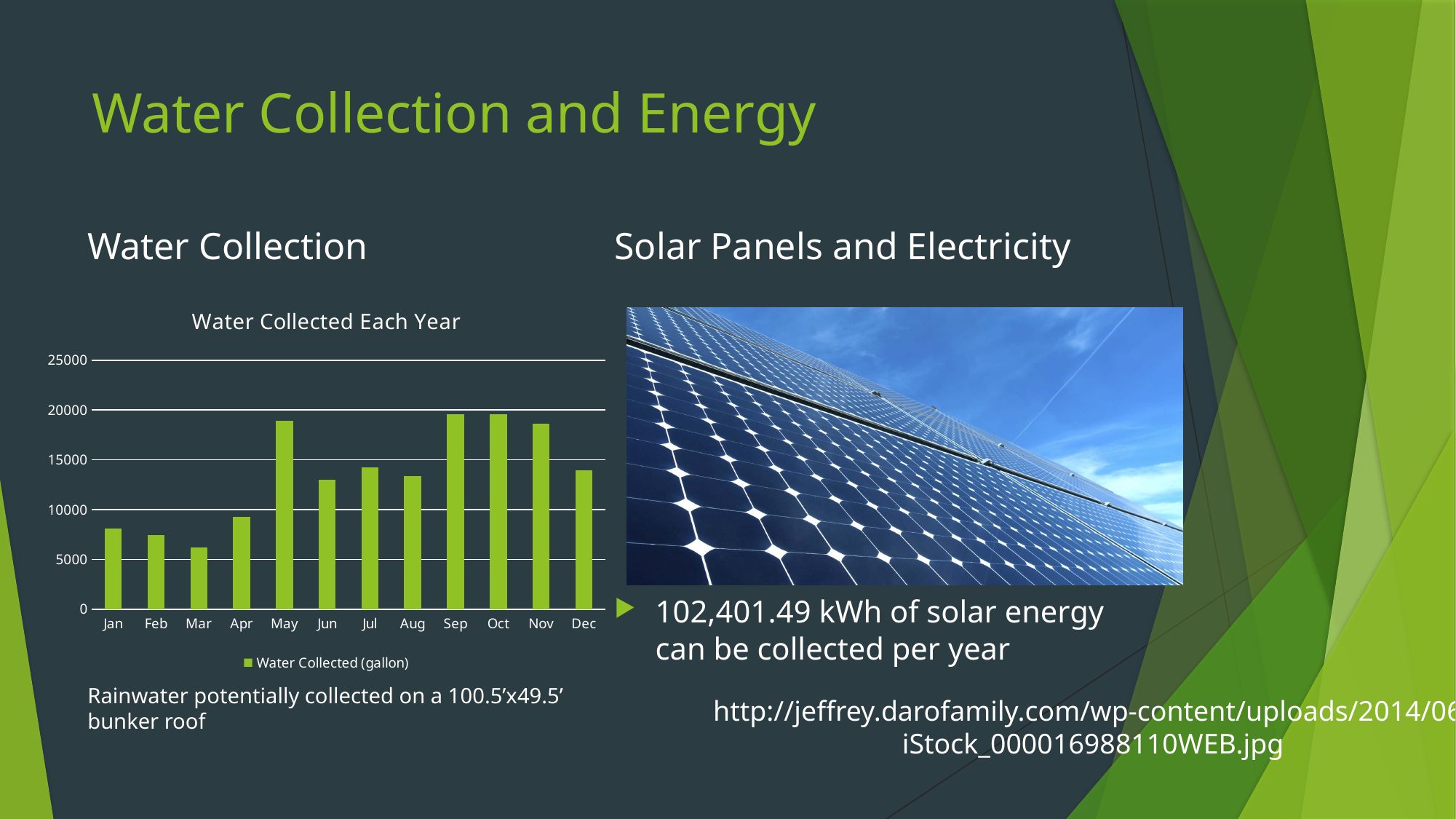
Which month has the lowest water collected in the chart? Mar Is the value for May greater or less than 15000? greater Which has a larger value, May or Jan? May How many series does the chart's legend list? 1 What kind of chart is shown on the slide? bar chart What is the title of the chart on the slide? Water Collected Each Year How many months are shown on the x axis of the chart? 12 Which has a larger value, Feb or Nov? Nov Is the value for Jan greater or less than 10000? less What series name is shown in the chart's legend? Water Collected (gallon) Is the value for Mar greater or less than 5000? greater